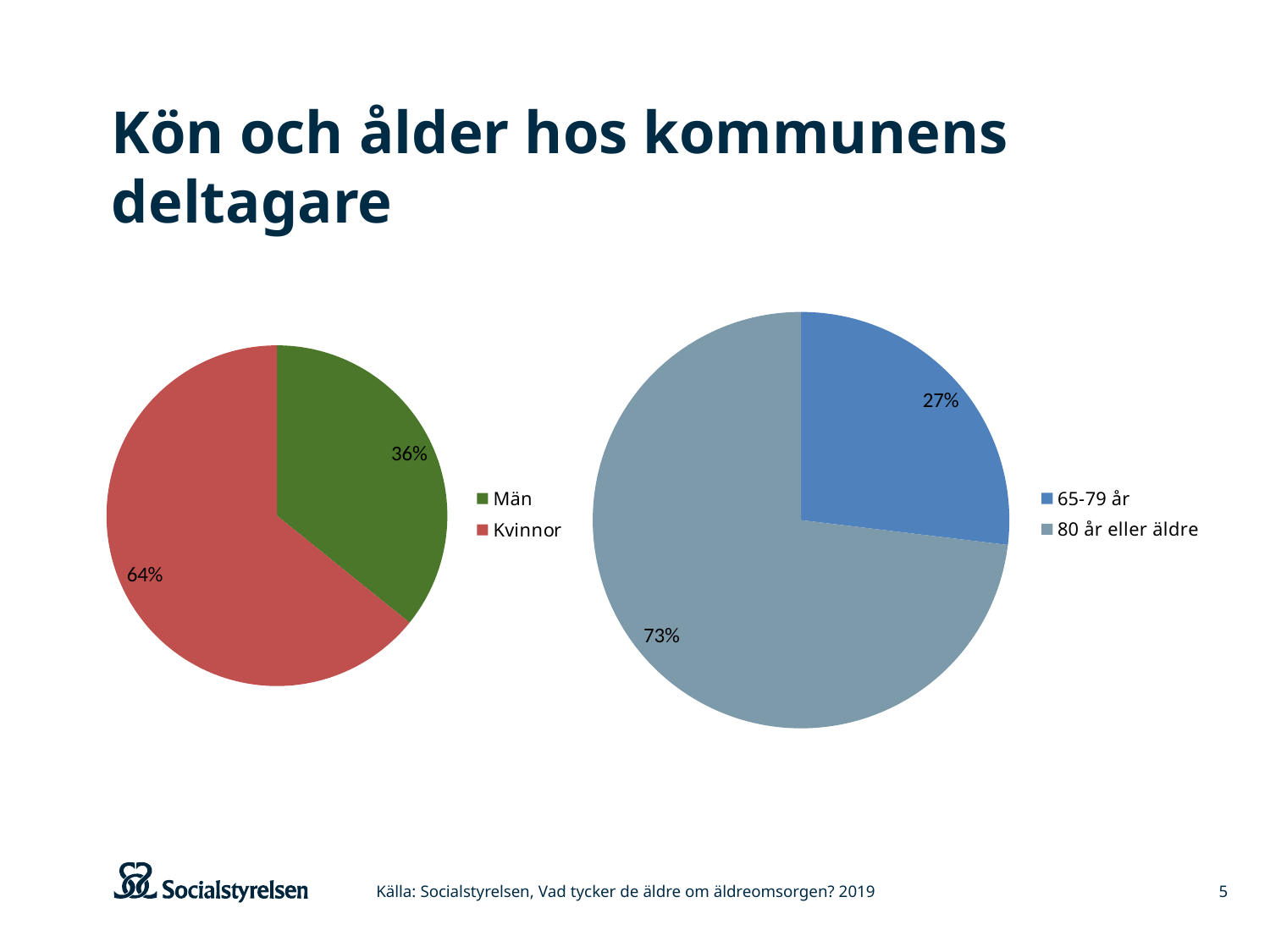
In the left pie chart (gender), what share of participants are Män? 36% In the right pie chart (age), which is larger: 65-79 år or 80 år eller äldre? 80 år eller äldre How many slices does the left pie chart (gender) have? 2 In the right pie chart (age), what is the difference in percentage points between 80 år eller äldre and 65-79 år? 46 What type of chart is the right chart (age)? Pie chart In the right pie chart (age), what share of participants are 65-79 år? 27% In the right pie chart (age), which category has the smallest share? 65-79 år In the left pie chart (gender), what is the difference in percentage points between Kvinnor and Män? 28 In the left pie chart (gender), what share of participants are Kvinnor? 64% In the left pie chart (gender), which category has the largest share? Kvinnor In the right pie chart (age), what share of participants are 80 år eller äldre? 73% In the left pie chart (gender), what colour is the Män slice? Green